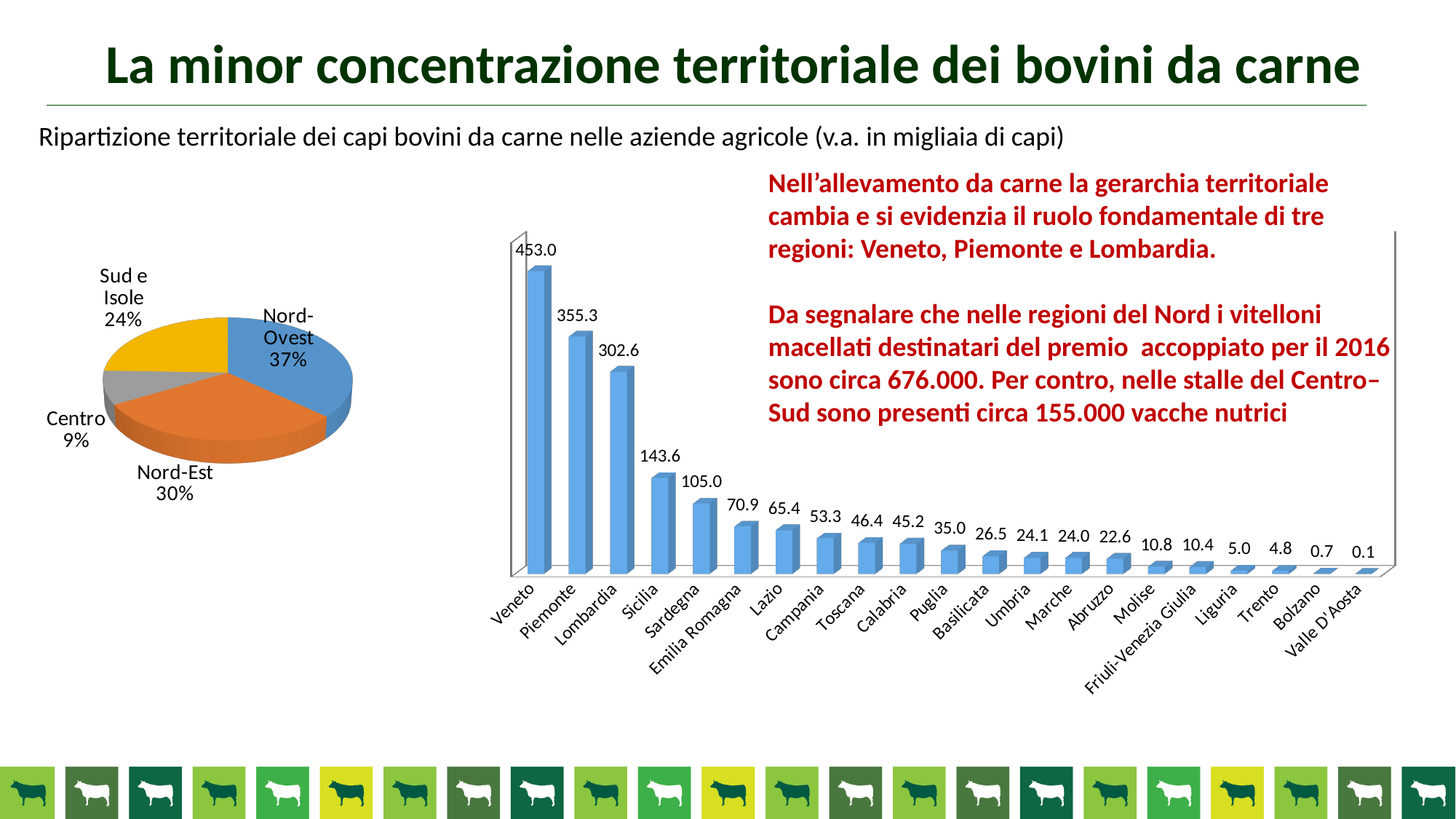
In the bar chart on the right, what is the difference between the values for Piemonte and Lombardia? 52.7 What kind of chart is the chart on the left of the slide? Pie chart In the bar chart on the right, what is the value for Friuli-Venezia Giulia? 10.4 In the bar chart on the right, do the values rise or fall from left to right along the x axis? Fall In the pie chart on the left, which area has the smallest share? Centro In the bar chart on the right, which is larger, the value for Sardegna or the value for Emilia Romagna? Sardegna In the bar chart on the right, what is the value for Sicilia? 143.6 In the bar chart on the right, which region has the lowest value? Valle D'Aosta In the pie chart on the left, what share does Nord-Ovest have? 37% How many regions are shown in the bar chart on the right? 21 In the bar chart on the right, what is the value for Veneto? 453.0 In the bar chart on the right, which region has the highest value? Veneto